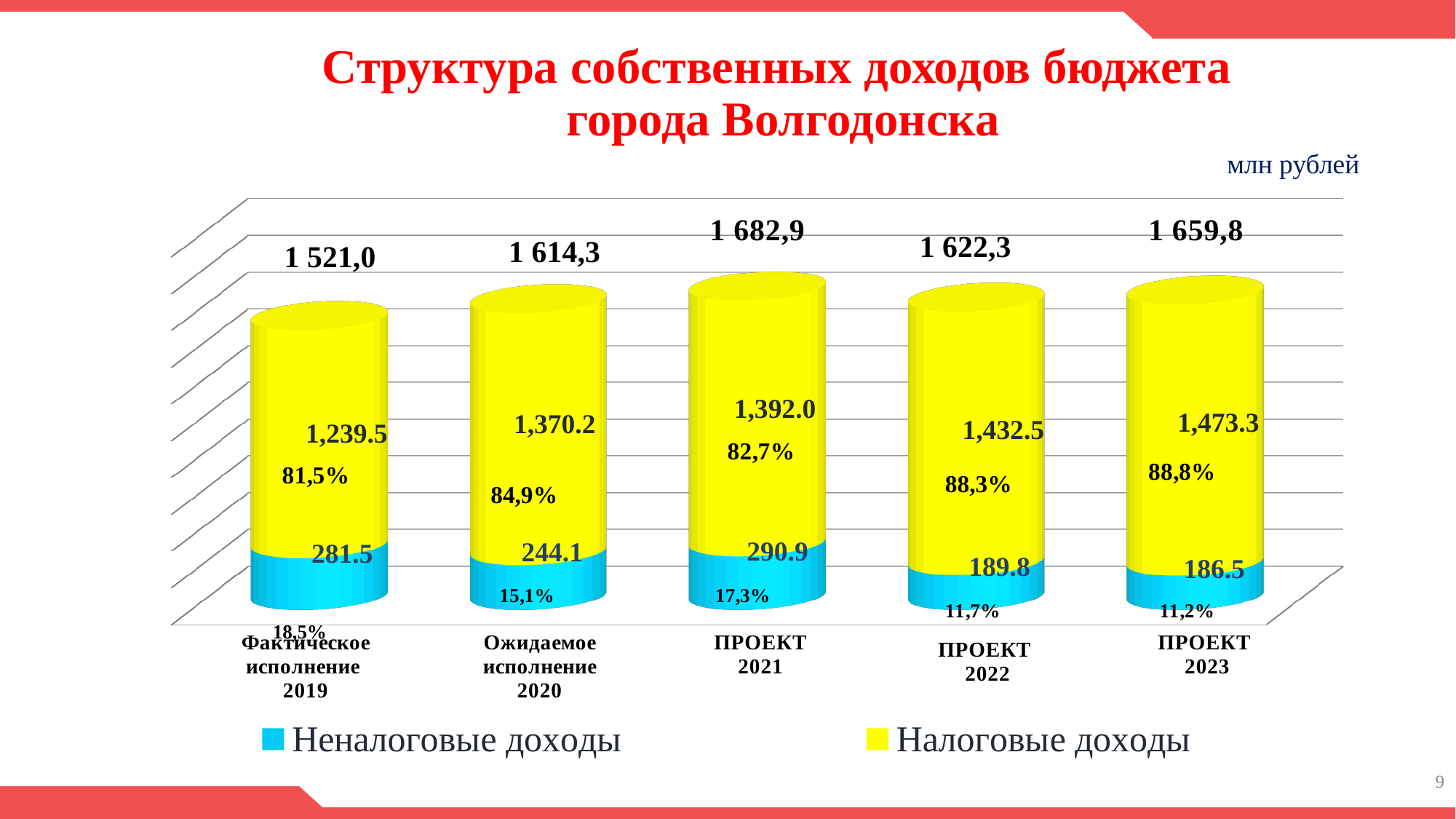
What is the difference between Налоговые доходы for ПРОЕКТ 2022 and for Фактическое исполнение 2019? 193.0 What is the value of Неналоговые доходы for Ожидаемое исполнение 2020? 244.1 Which category has the lowest value of Неналоговые доходы? ПРОЕКТ 2023 Which category has the highest value of Налоговые доходы? ПРОЕКТ 2023 What kind of chart is shown on the slide? Stacked bar chart What is the total shown above the bar for ПРОЕКТ 2023? 1 659,8 What percentage share of the total do Налоговые доходы make up for ПРОЕКТ 2022? 88,3% How many categories are shown on the x axis? 5 Which colour represents Неналоговые доходы in the legend? Blue What is the value of Налоговые доходы for ПРОЕКТ 2021? 1,392.0 How many series does the legend list? 2 Which is larger: Неналоговые доходы for ПРОЕКТ 2021 or for ПРОЕКТ 2022? ПРОЕКТ 2021